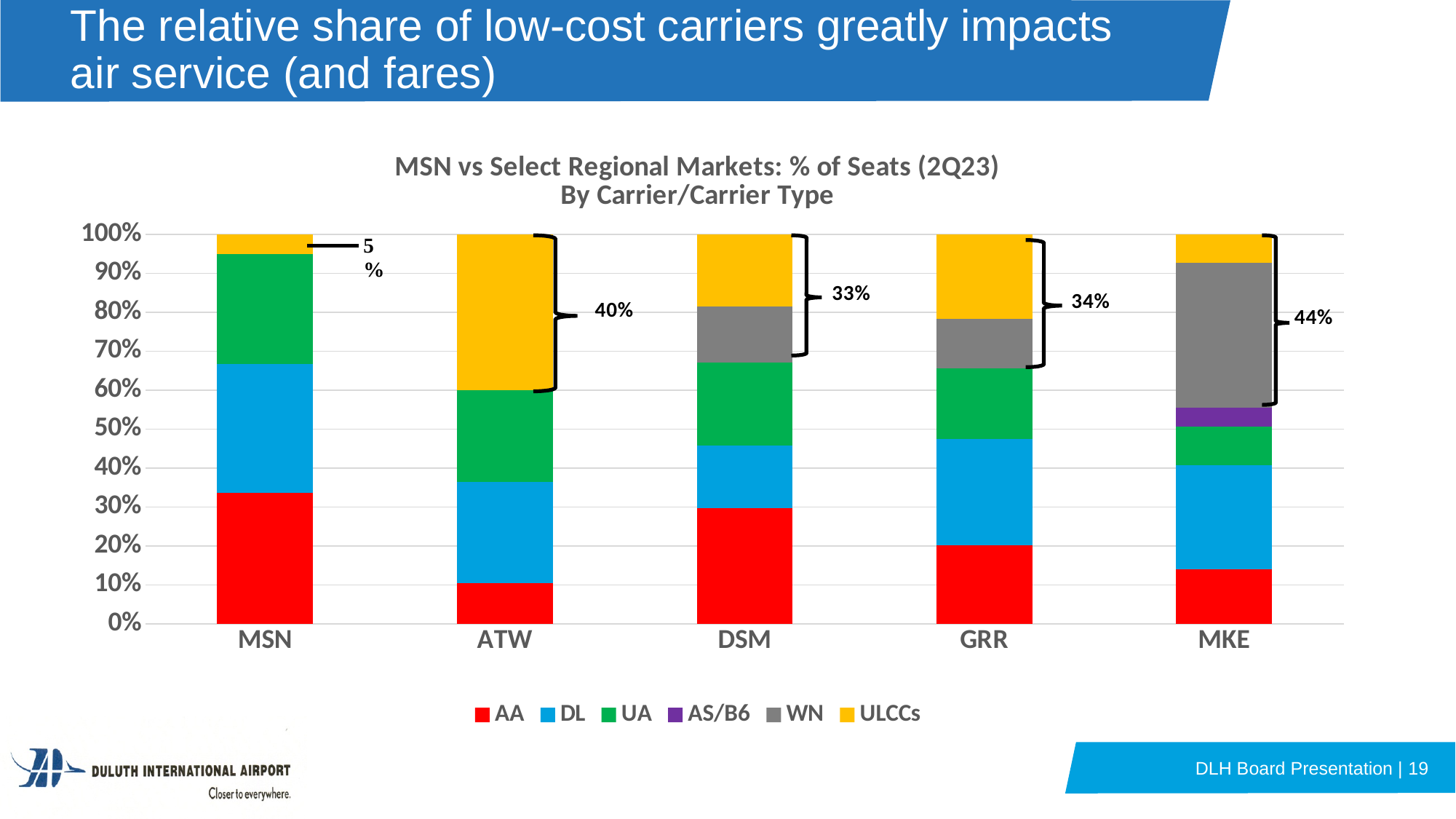
Is the AA share for ATW greater or less than 20%? less Which has a larger annotated low-cost carrier share, ATW or DSM? ATW What is the difference between the annotated low-cost shares of MKE and ATW? 4% What kind of chart is shown on the slide? Stacked bar chart What low-cost carrier share is annotated for ATW? 40% Which airport is the only one with an AS/B6 segment in its bar? MKE What low-cost carrier share is annotated for MKE? 44% How many series does the legend list? 6 How many airports (categories) are shown on the x axis? 5 Which airport has the highest annotated low-cost carrier share? MKE What low-cost carrier share is annotated for MSN? 5% Which airport has the lowest annotated low-cost carrier share? MSN